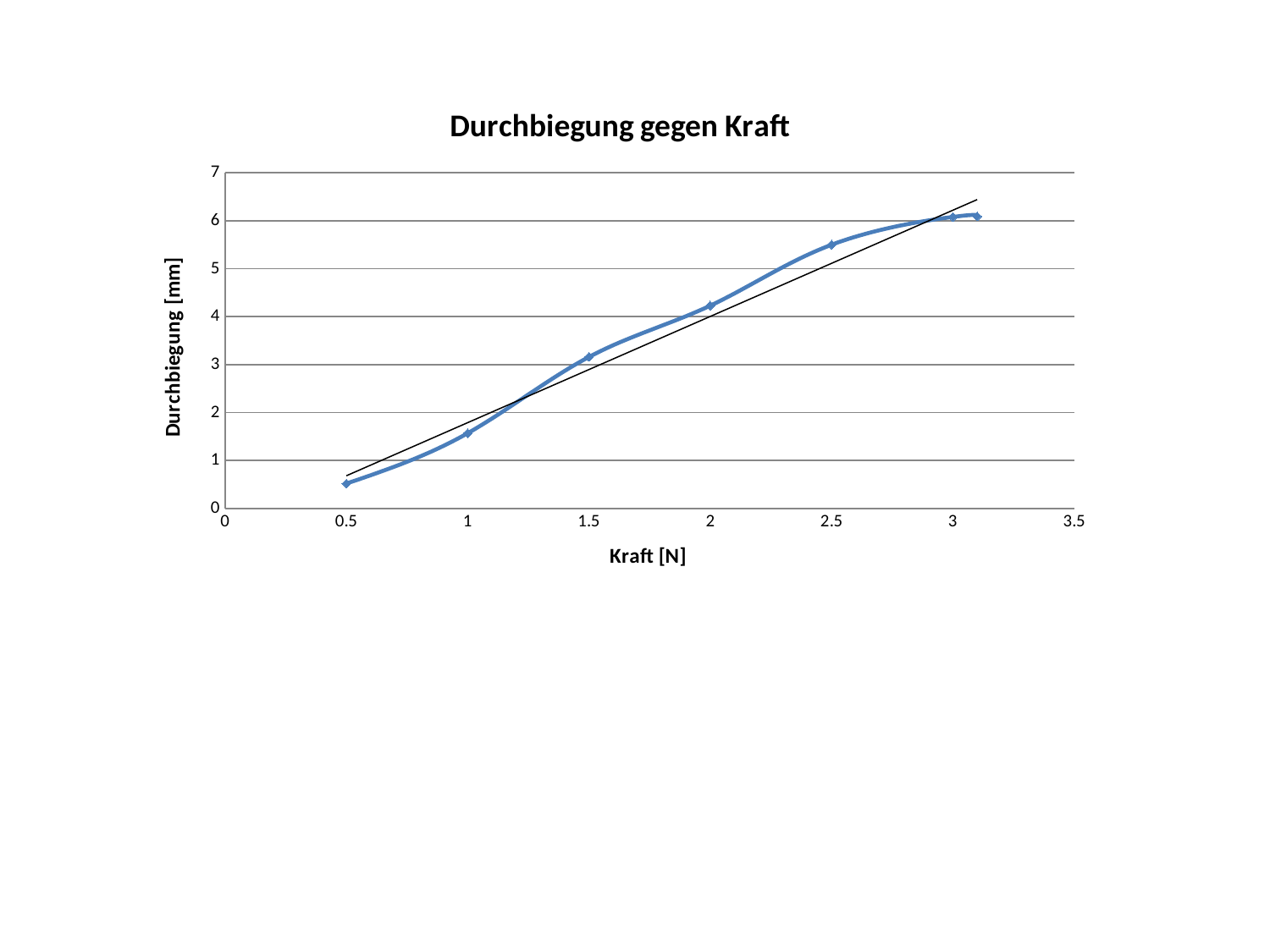
Is the Durchbiegung value at 1 N greater or less than 2? less What is the title of the chart? Durchbiegung gegen Kraft How many data points are plotted on the chart? 7 Is the Durchbiegung value at 2.5 N greater or less than 5? greater Is the Durchbiegung value at 2 N greater or less than 4? greater Does the Durchbiegung rise or fall as Kraft increases along the x axis? rise What kind of chart is shown on the slide? line chart At which Kraft value is the Durchbiegung lowest? 0.5 What is the label of the x axis? Kraft [N] Which has the larger Durchbiegung, the point at 2.5 N or the point at 1.5 N? 2.5 N